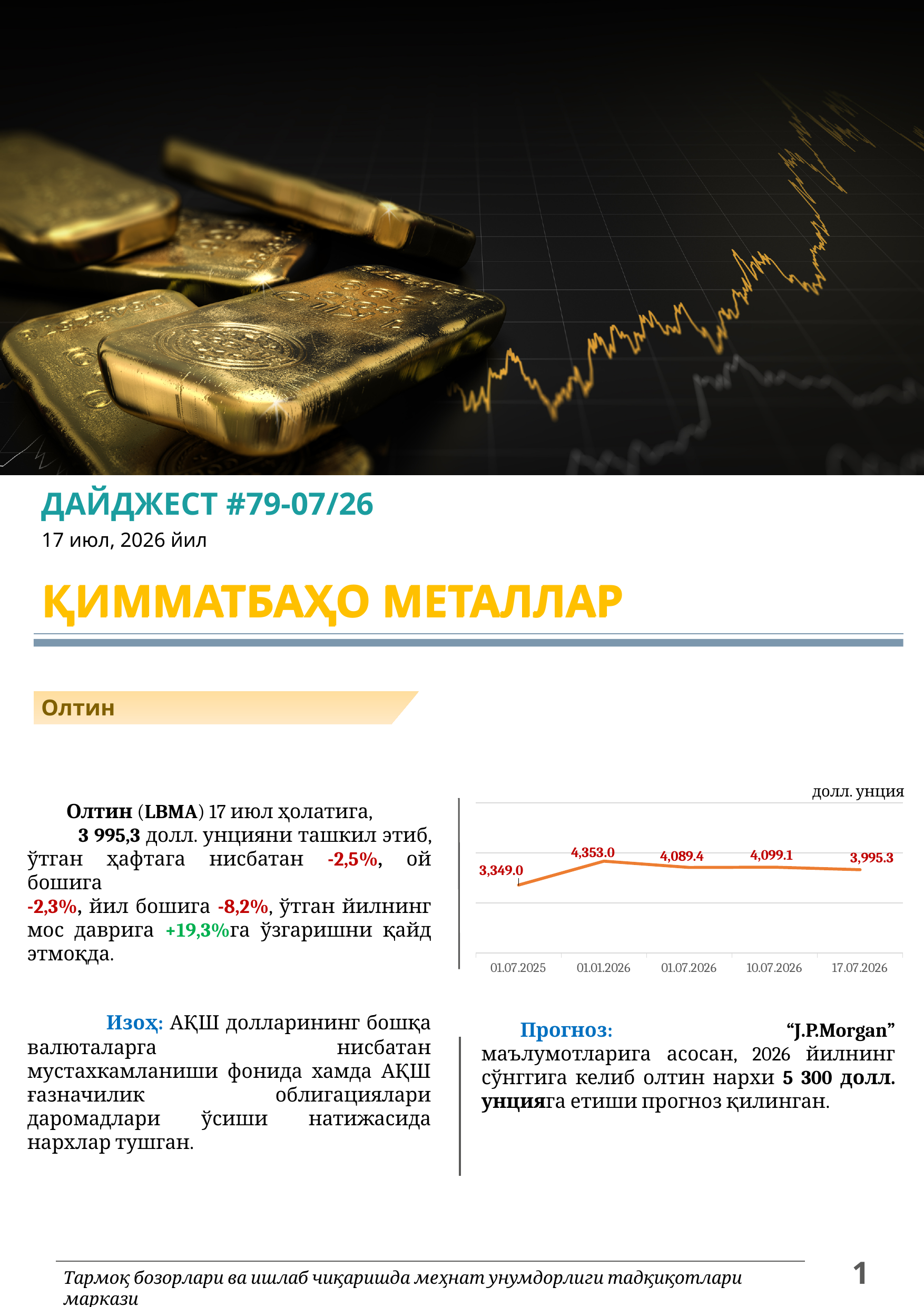
Which date has the lowest value on the gold price chart? 01.07.2025 Which is larger on the gold price chart: the value for 01.07.2026 or the value for 17.07.2026? 01.07.2026 What is the difference between the values for 01.01.2026 and 01.07.2025 on the gold price chart? 1,004.0 How many data points are plotted on the gold price chart? 5 What is the gold price value plotted for 17.07.2026? 3,995.3 What is the gold price value plotted for 10.07.2026? 4,099.1 What unit label is shown above the gold price chart? долл. унция What is the gold price value plotted for 01.07.2025? 3,349.0 Which date has the highest value on the gold price chart? 01.01.2026 What is the gold price value plotted for 01.01.2026? 4,353.0 What is the difference between the values for 01.01.2026 and 17.07.2026 on the gold price chart? 357.7 What type of chart is used to show the gold price? Line chart